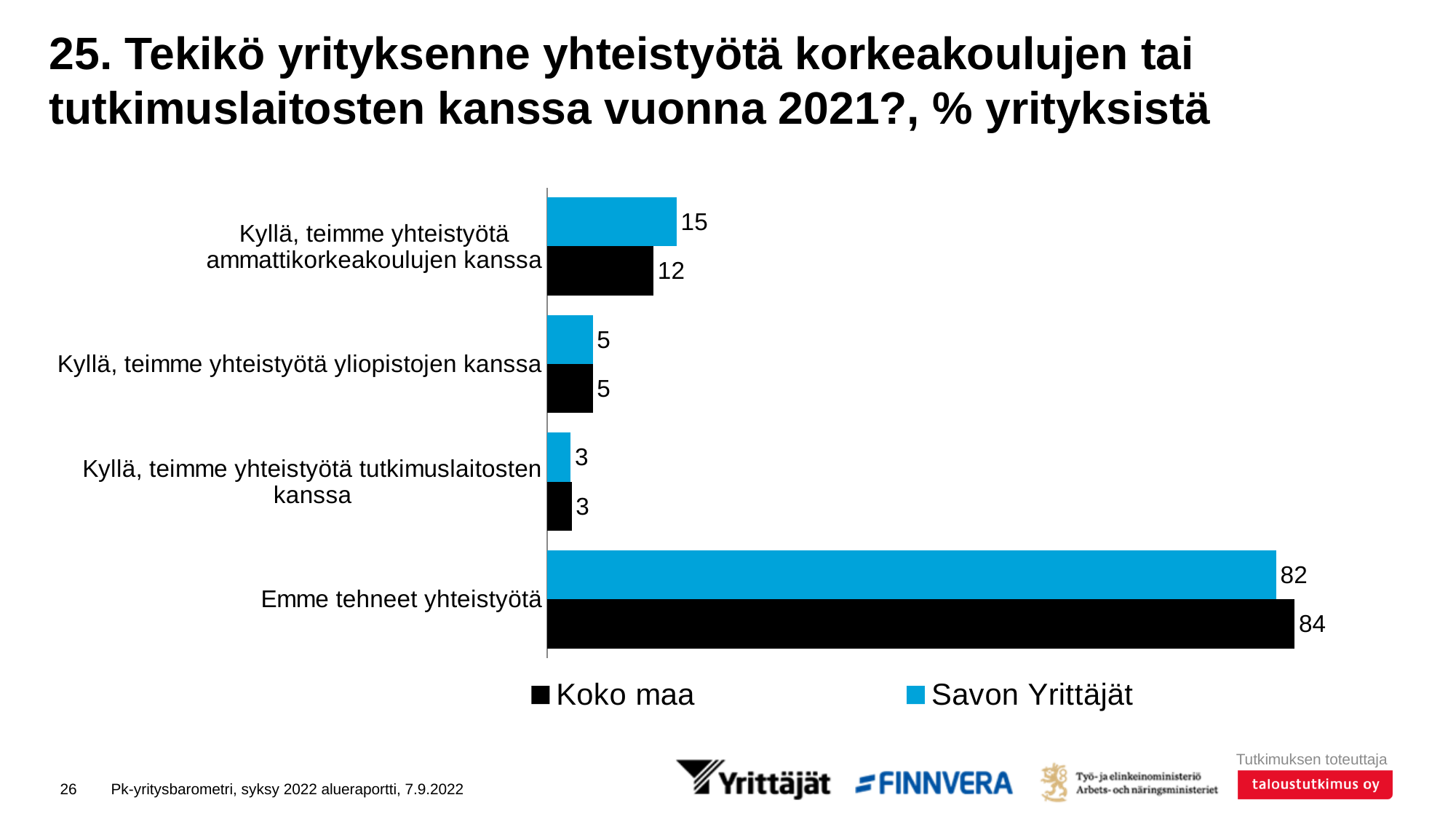
What is the value for Koko maa for 'Kyllä, teimme yhteistyötä yliopistojen kanssa'? 5 Which category has the lowest value for Koko maa? Kyllä, teimme yhteistyötä tutkimuslaitosten kanssa For 'Emme tehneet yhteistyötä', which series has the larger value, Koko maa or Savon Yrittäjät? Koko maa What is the value for Koko maa for 'Emme tehneet yhteistyötä'? 84 What is the difference between the Savon Yrittäjät and Koko maa values for 'Kyllä, teimme yhteistyötä ammattikorkeakoulujen kanssa'? 3 Which category has the highest value for Savon Yrittäjät? Emme tehneet yhteistyötä What is the value for Savon Yrittäjät for 'Kyllä, teimme yhteistyötä tutkimuslaitosten kanssa'? 3 What kind of chart is shown on the slide? Bar chart What is the value for Savon Yrittäjät for 'Kyllä, teimme yhteistyötä ammattikorkeakoulujen kanssa'? 15 How many series does the legend list? 2 How many categories are shown on the chart? 4 Which colour represents Savon Yrittäjät in the chart? Blue